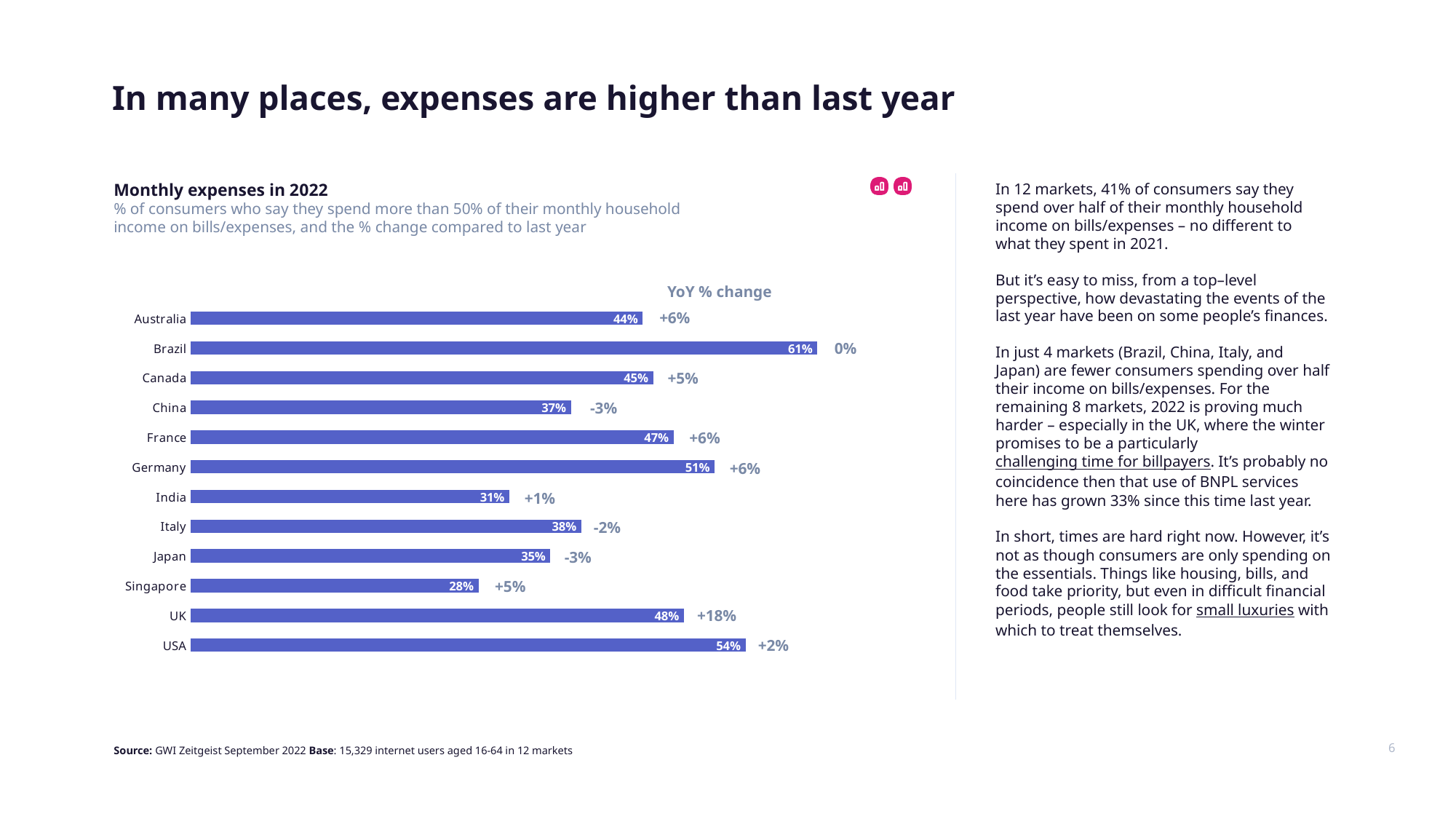
What is the YoY % change shown for China? -3% Which market has the highest percentage of consumers spending more than 50% of income on bills/expenses? Brazil What percentage of consumers in Brazil say they spend more than 50% of their monthly household income on bills/expenses? 61% What value is shown for Singapore? 28% Which market shows a YoY % change of 0%? Brazil What is the difference between the values for the USA and Germany? 3% What is the title of the chart? Monthly expenses in 2022 How many markets are shown in the chart? 12 What is the YoY % change shown for the UK? +18% Which market has the lowest percentage of consumers spending more than 50% of income on bills/expenses? Singapore What type of chart is used on the slide? Bar chart Which has a higher value, France or Canada? France